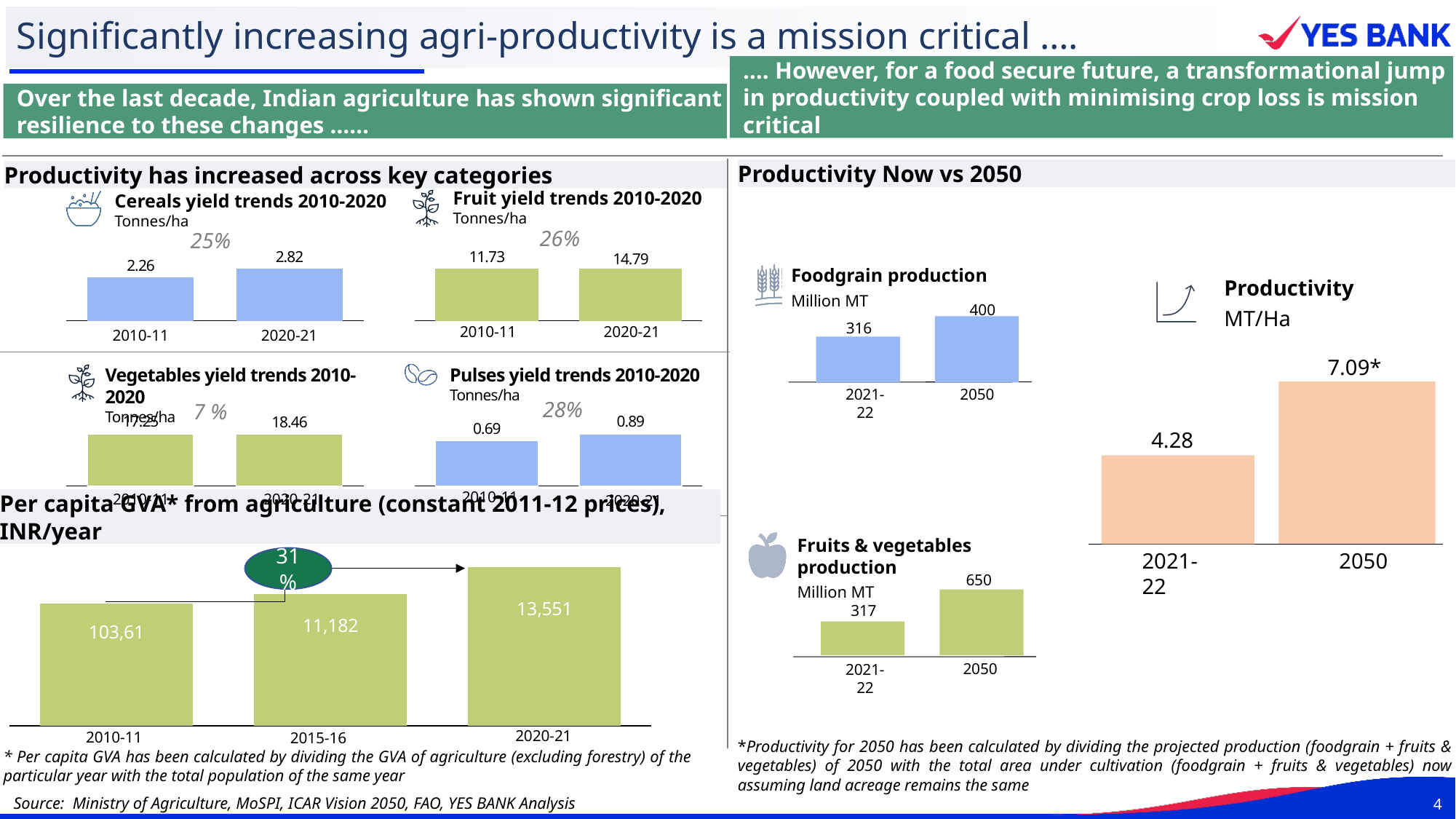
In the Cereals yield trends 2010-2020 chart, what is the difference between the 2020-21 and 2010-11 values? 0.56 In the Per capita GVA from agriculture chart, how many years are shown? 3 In the Pulses yield trends 2010-2020 chart, what is the difference between the 2020-21 and 2010-11 values? 0.20 In the Foodgrain production chart, what is the value for 2050? 400 In the Pulses yield trends 2010-2020 chart, what is the value for 2020-21? 0.89 In the Fruits & vegetables production chart, what is the difference between the 2050 and 2021-22 values? 333 In the Fruit yield trends 2010-2020 chart, what is the value for 2010-11? 11.73 In the Per capita GVA from agriculture chart, what is the value for 2020-21? 13,551 In the Vegetables yield trends chart, what is the value for 2020-21? 18.46 In the Fruit yield trends 2010-2020 chart, which year has the higher value? 2020-21 In the Cereals yield trends 2010-2020 chart, what is the value for 2020-21? 2.82 In the Productivity MT/Ha chart, what is the value for 2021-22? 4.28